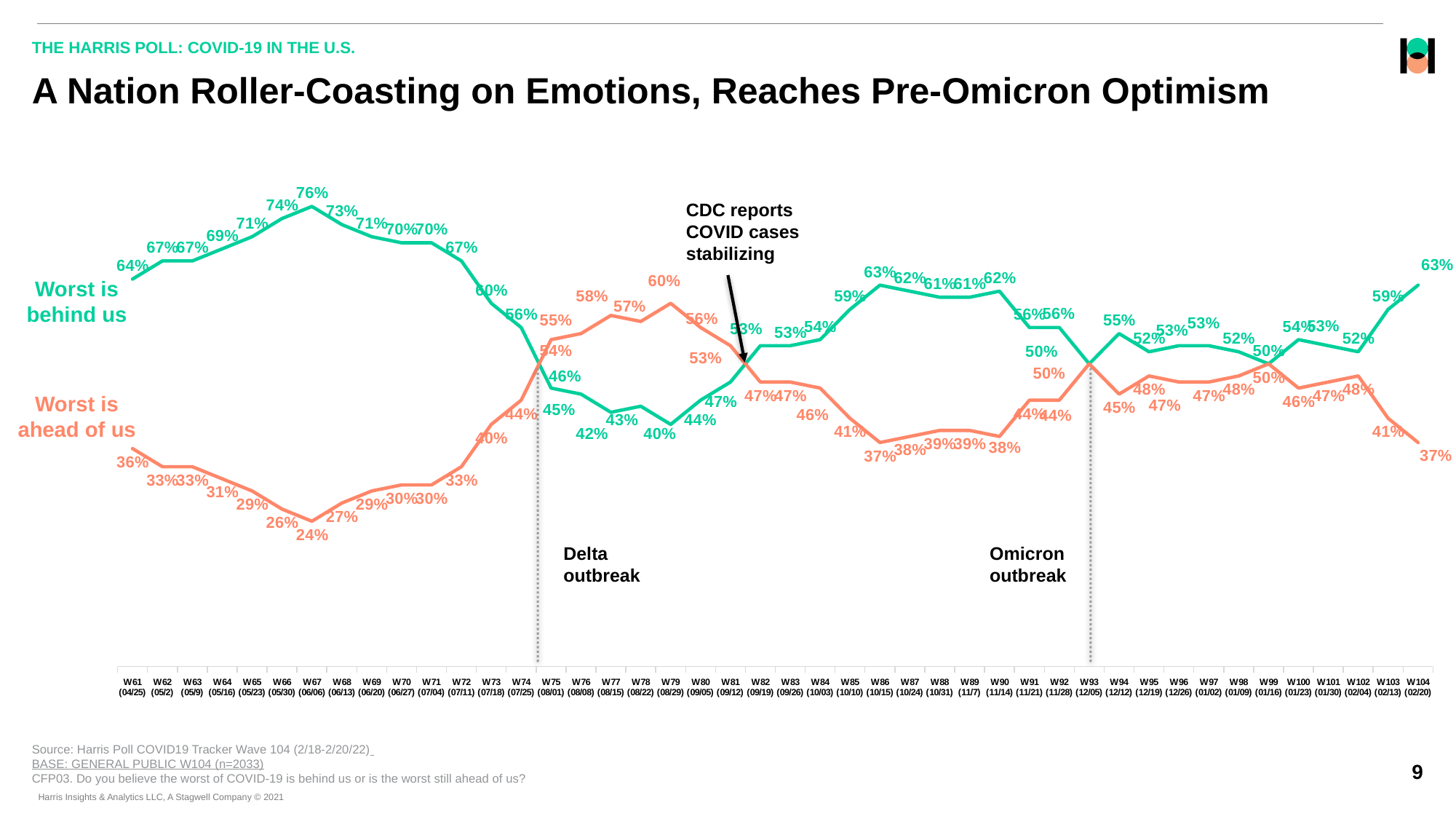
What is the value for "Worst is behind us" at W104 (02/20)? 63% How many series does the chart show? 2 How many waves are plotted on the x axis? 44 What is the highest value reached by "Worst is ahead of us"? 60% At which wave does "Worst is ahead of us" reach its lowest value? W67 (06/06), 24% What is the value for "Worst is behind us" at W61 (04/25)? 64% At which wave does "Worst is behind us" reach its highest value? W67 (06/06), 76% What is the difference between "Worst is behind us" and "Worst is ahead of us" at W104 (02/20)? 26 percentage points Which two outbreaks are marked with dotted vertical lines on the chart? Delta outbreak and Omicron outbreak What type of chart is shown on the slide? Line chart What is the value for "Worst is ahead of us" at W104 (02/20)? 37% At W79 (08/22), which series is larger: "Worst is behind us" or "Worst is ahead of us"? Worst is ahead of us